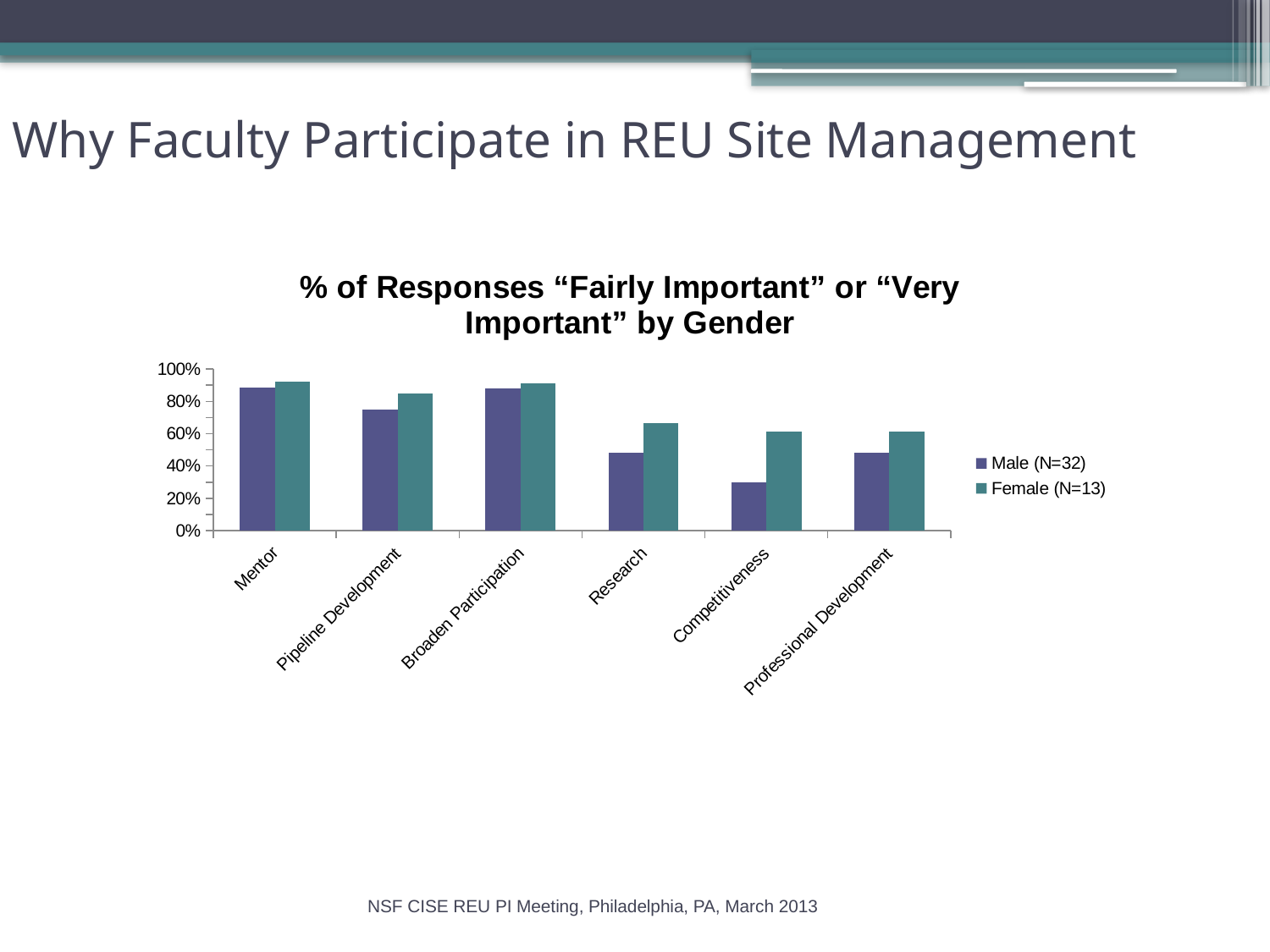
Is the Male (N=32) value for Competitiveness greater or less than 40%? less For Research, which series has the larger value, Male (N=32) or Female (N=13)? Female (N=13) Is the Female (N=13) value for Mentor greater or less than 80%? greater What is the title of the chart? % of Responses "Fairly Important" or "Very Important" by Gender What kind of chart is shown on the slide? Bar chart For Competitiveness, which series has the larger value, Male (N=32) or Female (N=13)? Female (N=13) How many series does the chart's legend list? 2 How many categories are shown on the x axis of the chart? 6 Which category has the lowest value for the Male (N=32) series? Competitiveness Is the Male (N=32) value for Pipeline Development greater or less than 80%? less